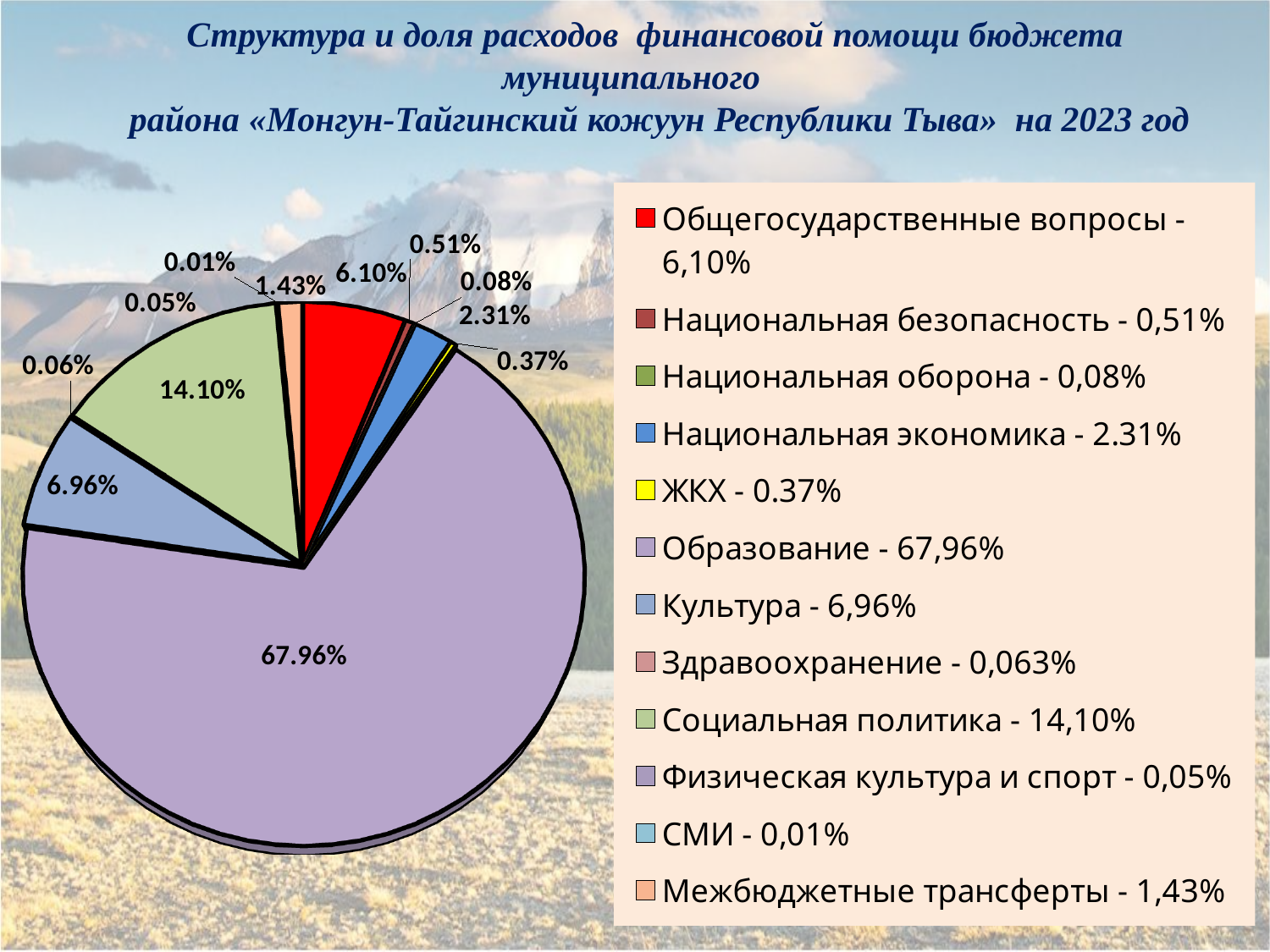
Which category has the smallest share of the pie? СМИ What is the value shown for Культура? 6.96% Which is larger, the share for Культура or the share for Общегосударственные вопросы? Культура What is the value shown for Социальная политика? 14.10% How many entries does the legend list? 12 What is the value shown for Общегосударственные вопросы? 6.10% What is the difference between the shares for Социальная политика and Культура? 7.14% What share of the pie does Образование take? 67.96% How many slices does the pie chart have? 12 What is the value shown for Национальная экономика? 2.31% What kind of chart is shown on the slide? pie chart Which category has the largest share of the pie? Образование